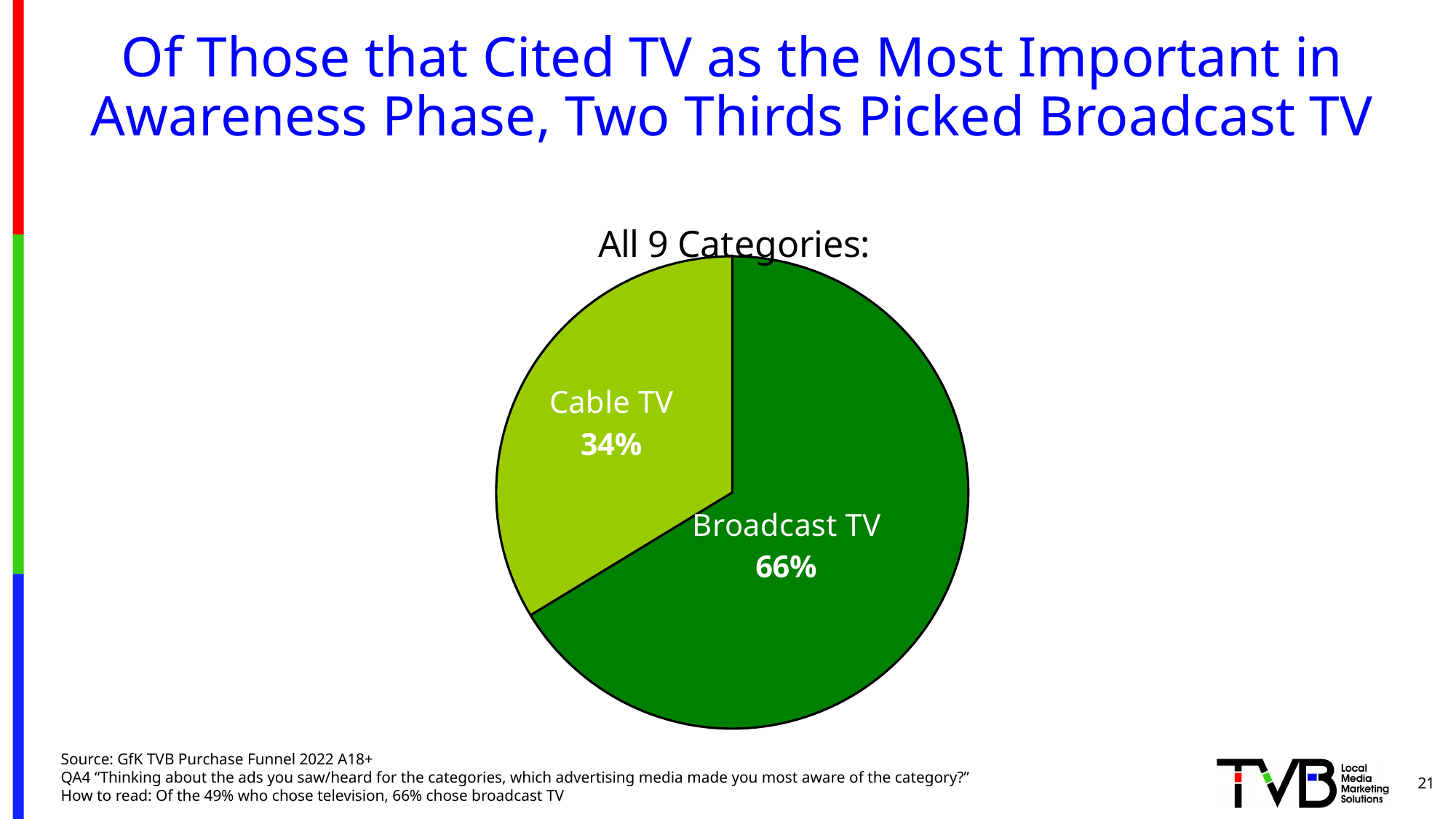
What is the title shown above the pie chart? All 9 Categories: What colour is the Cable TV slice? light green What share of the pie does Broadcast TV have? 66% Which slice of the pie is the smallest? Cable TV What is the difference in percentage points between Broadcast TV and Cable TV? 32 What kind of chart is shown on the slide? pie chart How many slices does the pie chart have? 2 Which slice of the pie is the largest? Broadcast TV What share of the pie does Cable TV have? 34% Which is larger, the Cable TV slice or the Broadcast TV slice? Broadcast TV